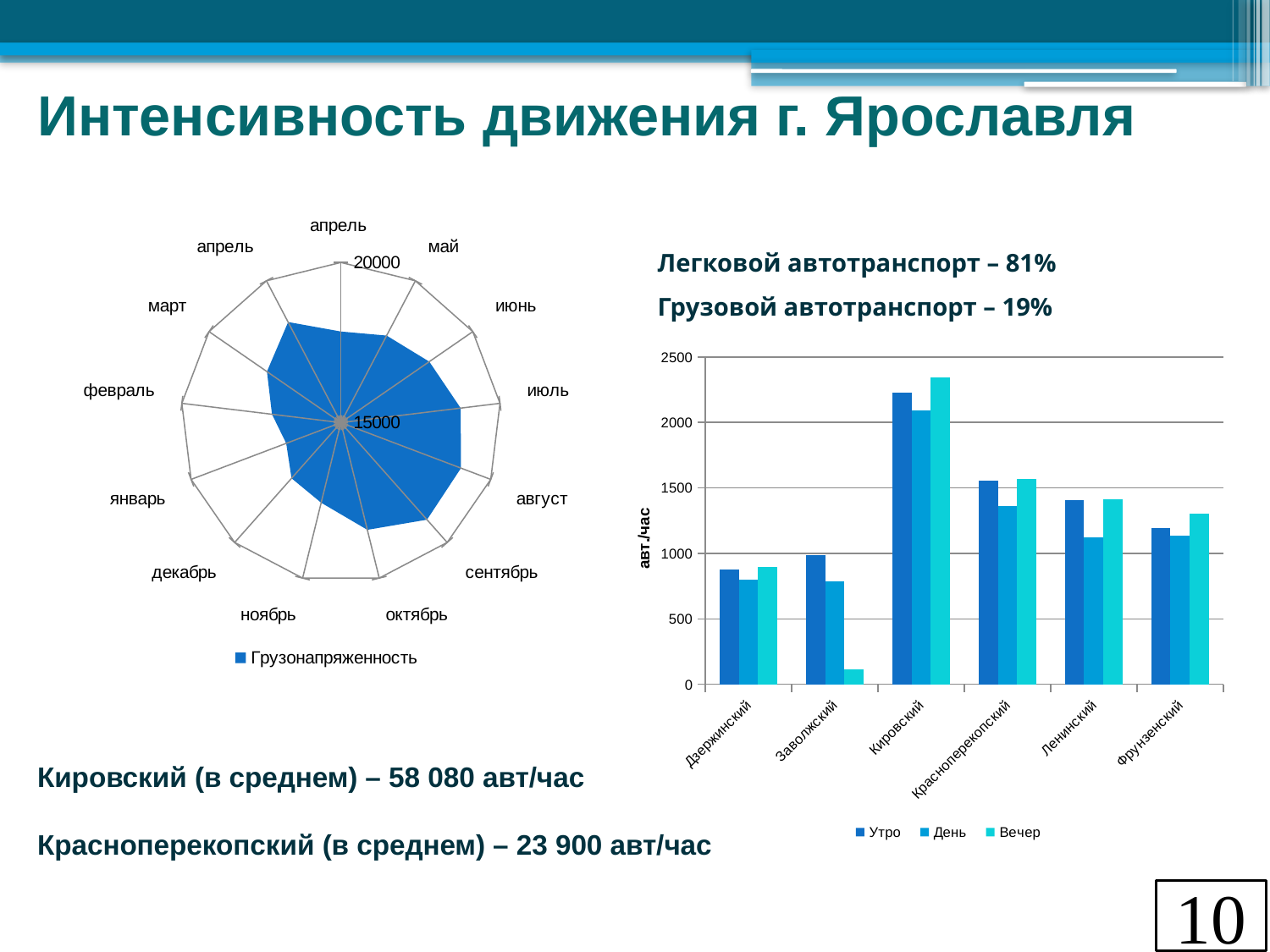
In the bar chart on the right, is the Утро value for Дзержинский greater or less than 1000? less In the bar chart on the right, is the Вечер value for Кировский greater or less than 2000? greater What is the legend entry of the radar chart on the left? Грузонапряженность What kind of chart is the chart on the left side of the slide? radar chart What kind of chart is the chart on the right side of the slide? bar chart In the bar chart on the right, which district has the lowest Вечер value? Заволжский In the bar chart on the right, which is larger: the Утро value for Кировский or the Утро value for Ленинский? Кировский In the bar chart on the right, how many series does the legend list? 3 What is the y-axis label of the bar chart on the right? авт./час In the bar chart on the right, which district has the highest bars? Кировский In the bar chart on the right, is the Вечер value for Заволжский greater or less than 500? less In the bar chart on the right, how many districts are shown on the x axis? 6